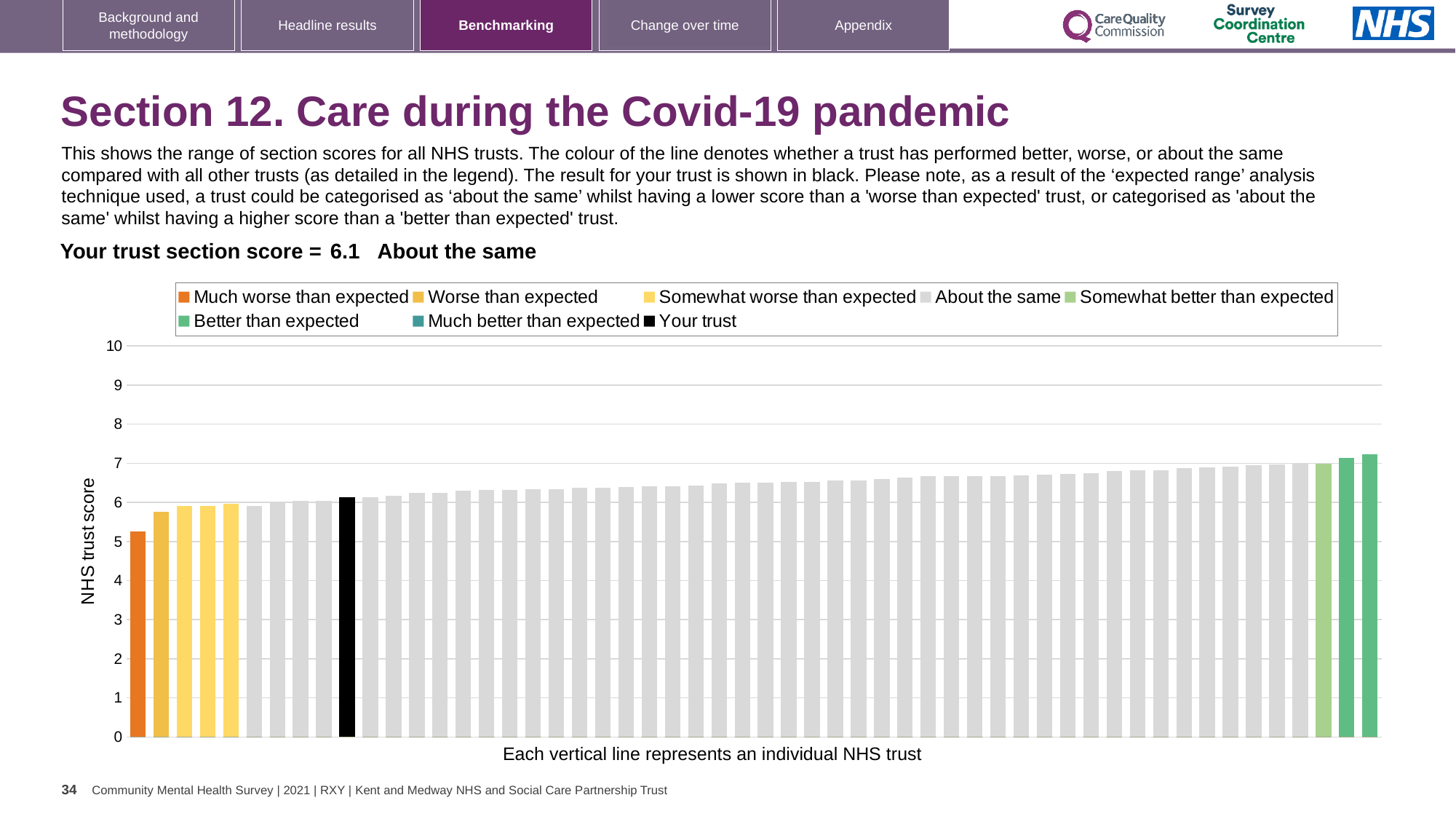
How many entries does the chart legend list? 8 Is the value of the highest bar greater or less than 7? greater What is the section score for 'Your trust' shown on the slide? 6.1 What kind of chart is shown on the slide? Bar chart Is the value of the lowest (orange) bar greater or less than 6? less What is the label on the vertical axis of the chart? NHS trust score Which legend category does the highest bar in the chart belong to? Better than expected How many bars in the chart are coloured orange ('Much worse than expected')? 1 Which legend category does the lowest bar in the chart belong to? Much worse than expected Which is higher, the black 'Your trust' bar or the orange 'Much worse than expected' bar? The black 'Your trust' bar Is the value of the black 'Your trust' bar greater or less than 5? greater Do the bar values rise or fall from left to right along the x axis? Rise